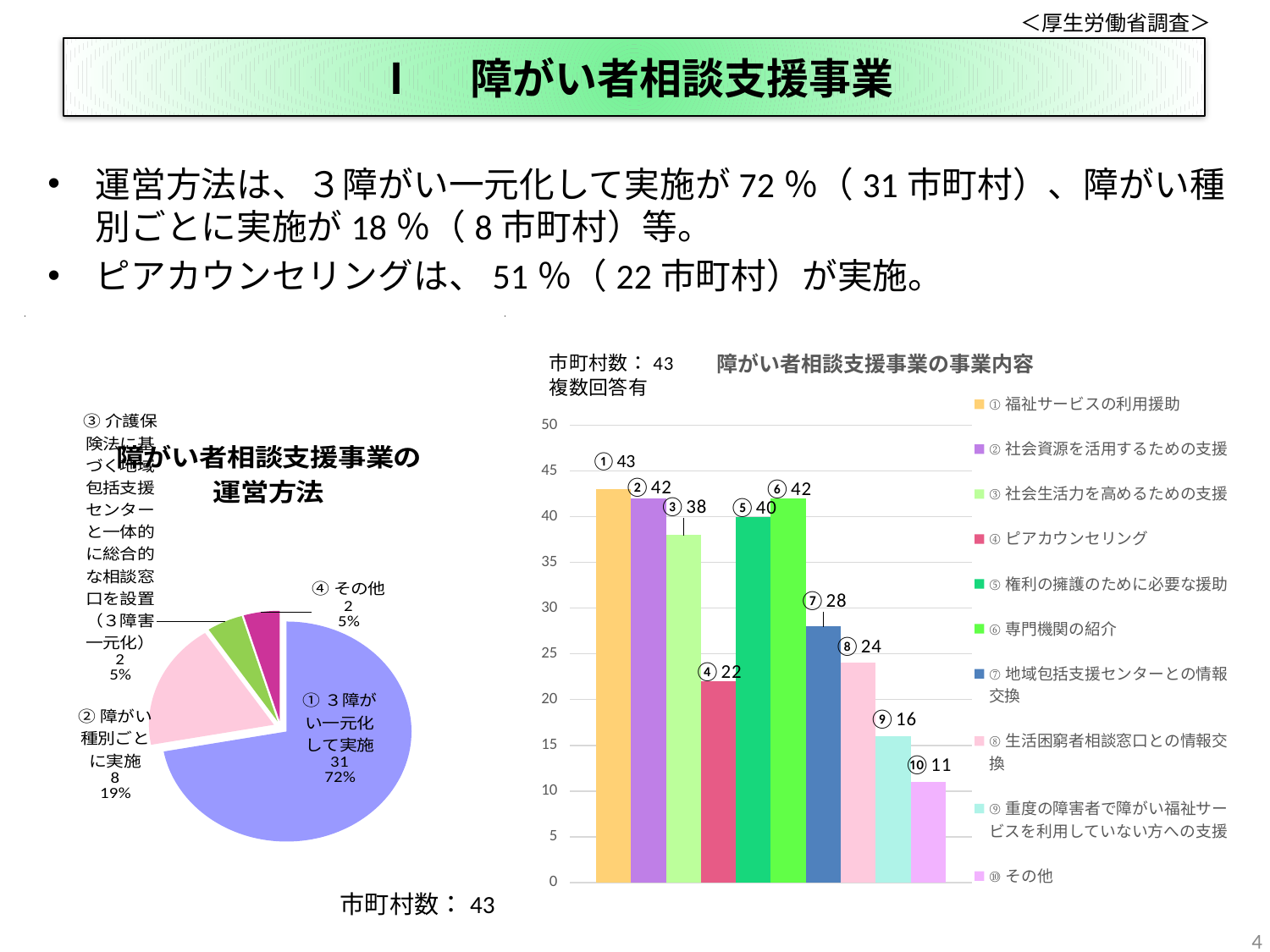
「障がい者相談支援事業の事業内容」のグラフで、最も値が大きい項目はどれですか？ ① 福祉サービスの利用援助 「障がい者相談支援事業の事業内容」のグラフで、「⑦ 地域包括支援センターとの情報交換」と「⑧ 生活困窮者相談窓口との情報交換」の値の差はいくつですか？ 4 「障がい者相談支援事業の事業内容」のグラフはどの種類のグラフですか？ 棒グラフ 「障がい者相談支援事業の事業内容」のグラフで、「① 福祉サービスの利用援助」の値はいくつですか？ 43 「障がい者相談支援事業の事業内容」のグラフで、最も値が小さい項目はどれですか？ ⑩ その他 「障がい者相談支援事業の運営方法」のグラフには、いくつの区分がありますか？ 4 「障がい者相談支援事業の事業内容」のグラフの凡例には、いくつの項目がありますか？ 10 「障がい者相談支援事業の事業内容」のグラフで、「⑤ 権利の擁護のために必要な援助」と「⑥ 専門機関の紹介」ではどちらの値が大きいですか？ ⑥ 専門機関の紹介 「障がい者相談支援事業の運営方法」のグラフで、「① ３障がい一元化して実施」の割合は何％ですか？ 72% 「障がい者相談支援事業の運営方法」のグラフで、「② 障がい種別ごとに実施」の市町村数はいくつですか？ 8 「障がい者相談支援事業の運営方法」のグラフはどの種類のグラフですか？ 円グラフ 「障がい者相談支援事業の事業内容」のグラフで、「④ ピアカウンセリング」の値はいくつですか？ 22